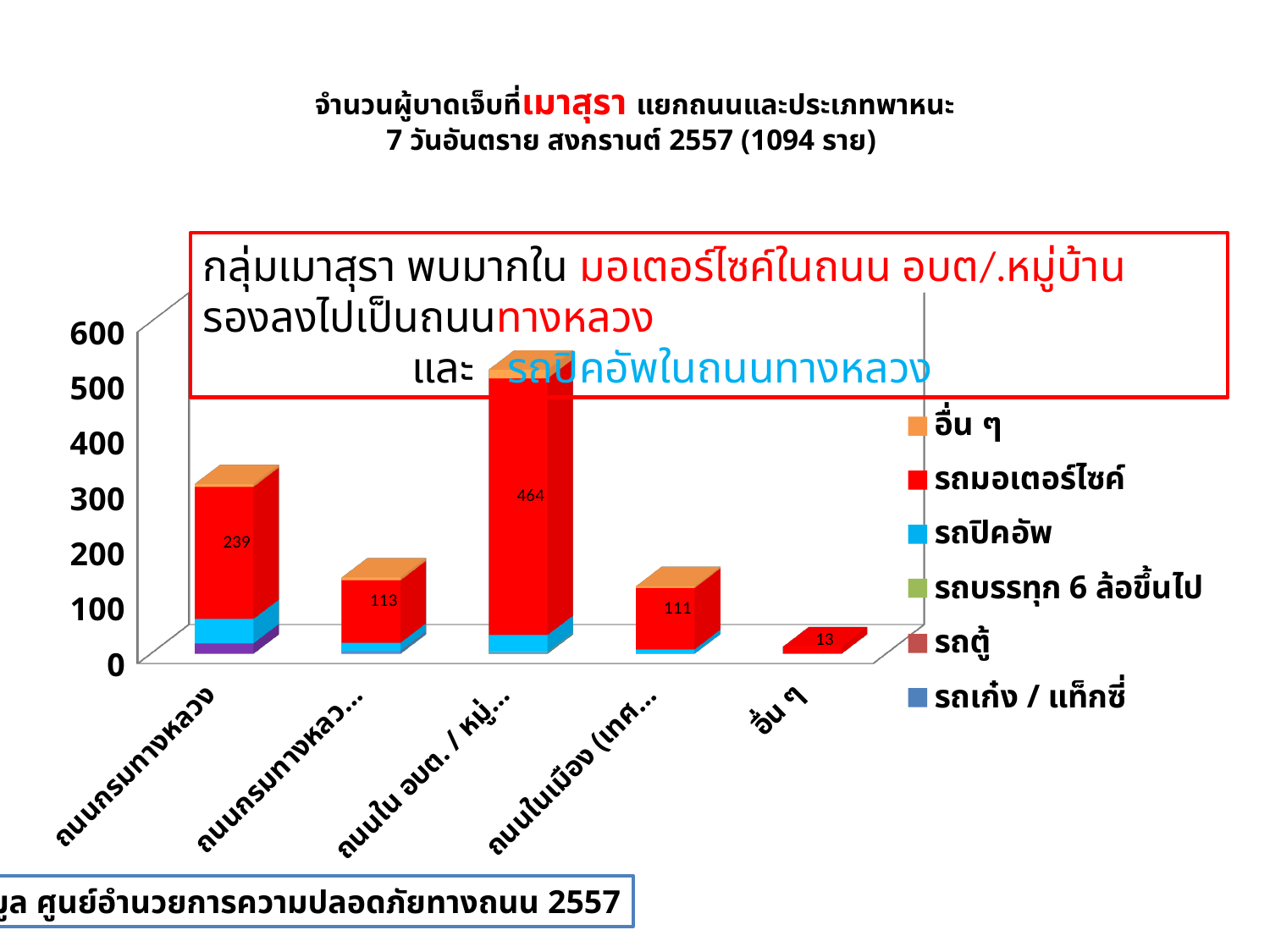
What is the difference between the รถมอเตอร์ไซค์ values of the third category (464) and ถนนกรมทางหลวง (239)? 225 What is the value labelled for รถมอเตอร์ไซค์ in the ถนนกรมทางหลวง category? 239 How many road categories are shown on the x axis? 5 Which category has the lowest labelled value for รถมอเตอร์ไซค์? อื่น ๆ Which is larger, the รถมอเตอร์ไซค์ value for ถนนกรมทางหลวง or for the second category? ถนนกรมทางหลวง Which category has the highest labelled value for รถมอเตอร์ไซค์? ถนนใน อบต. / หมู่บ้าน (third category) What is the value labelled for รถมอเตอร์ไซค์ in the third category (ถนนใน อบต.)? 464 What type of chart is shown on the slide? bar chart What is the value labelled for รถมอเตอร์ไซค์ in the อื่น ๆ category? 13 What colour represents รถมอเตอร์ไซค์ in the legend? red How many series does the legend list? 6 Is the total height of the stacked bar for อื่น ๆ greater or less than 100? less